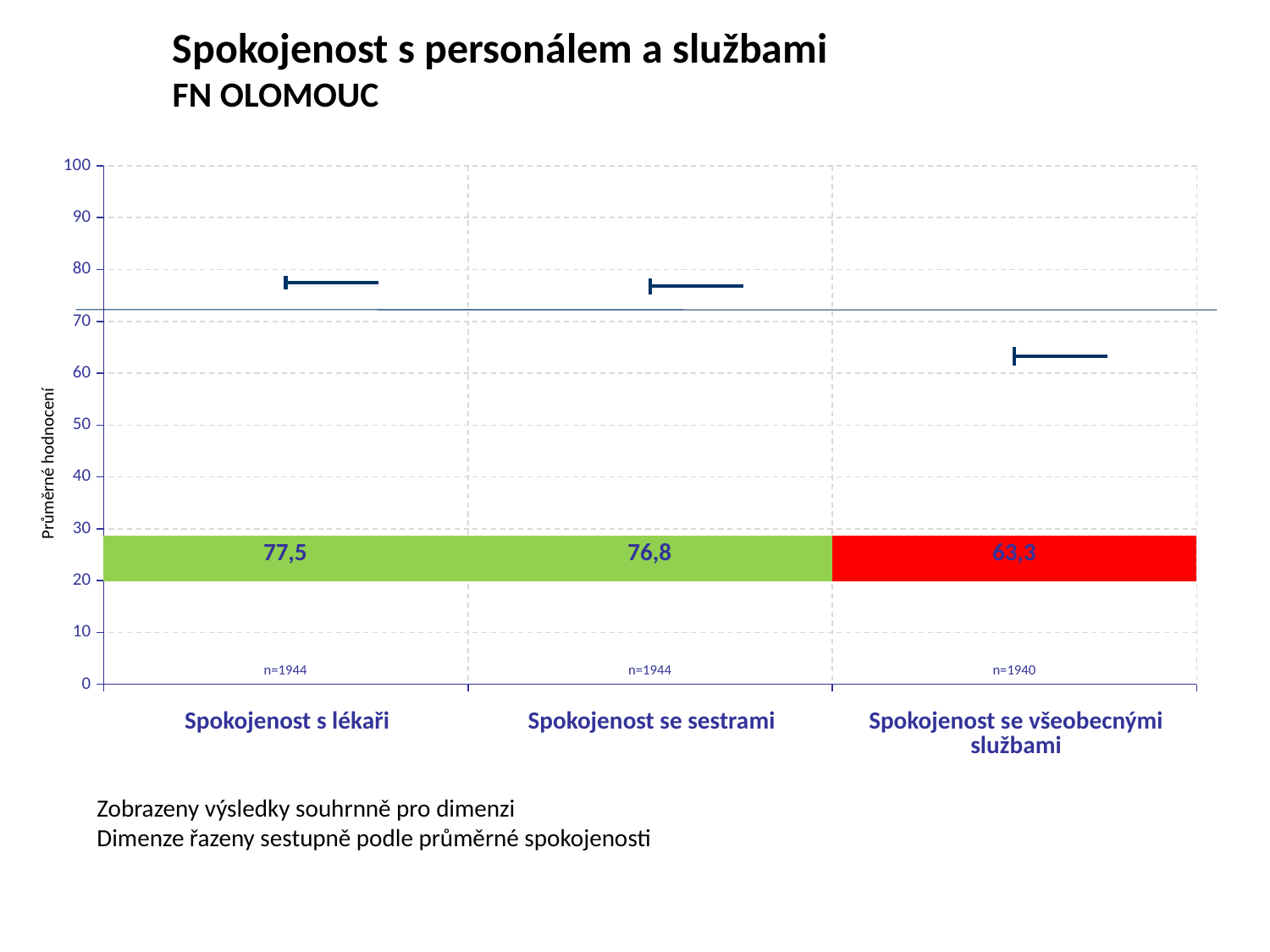
What is the difference between the values for Spokojenost s lékaři and Spokojenost se všeobecnými službami? 14,2 Which is larger, the value for Spokojenost se sestrami or the value for Spokojenost se všeobecnými službami? Spokojenost se sestrami Is the value for Spokojenost se všeobecnými službami greater or less than 70? less Which category has the lowest value? Spokojenost se všeobecnými službami What is the sample size (n) shown for Spokojenost se všeobecnými službami? n=1940 What is the value for Spokojenost s lékaři? 77,5 Which category has the highest value? Spokojenost s lékaři How many categories are shown on the x axis? 3 What is the value for Spokojenost se sestrami? 76,8 What is the value for Spokojenost se všeobecnými službami? 63,3 What is the difference between the values for Spokojenost se sestrami and Spokojenost se všeobecnými službami? 13,5 What is the title of the chart? Spokojenost s personálem a službami